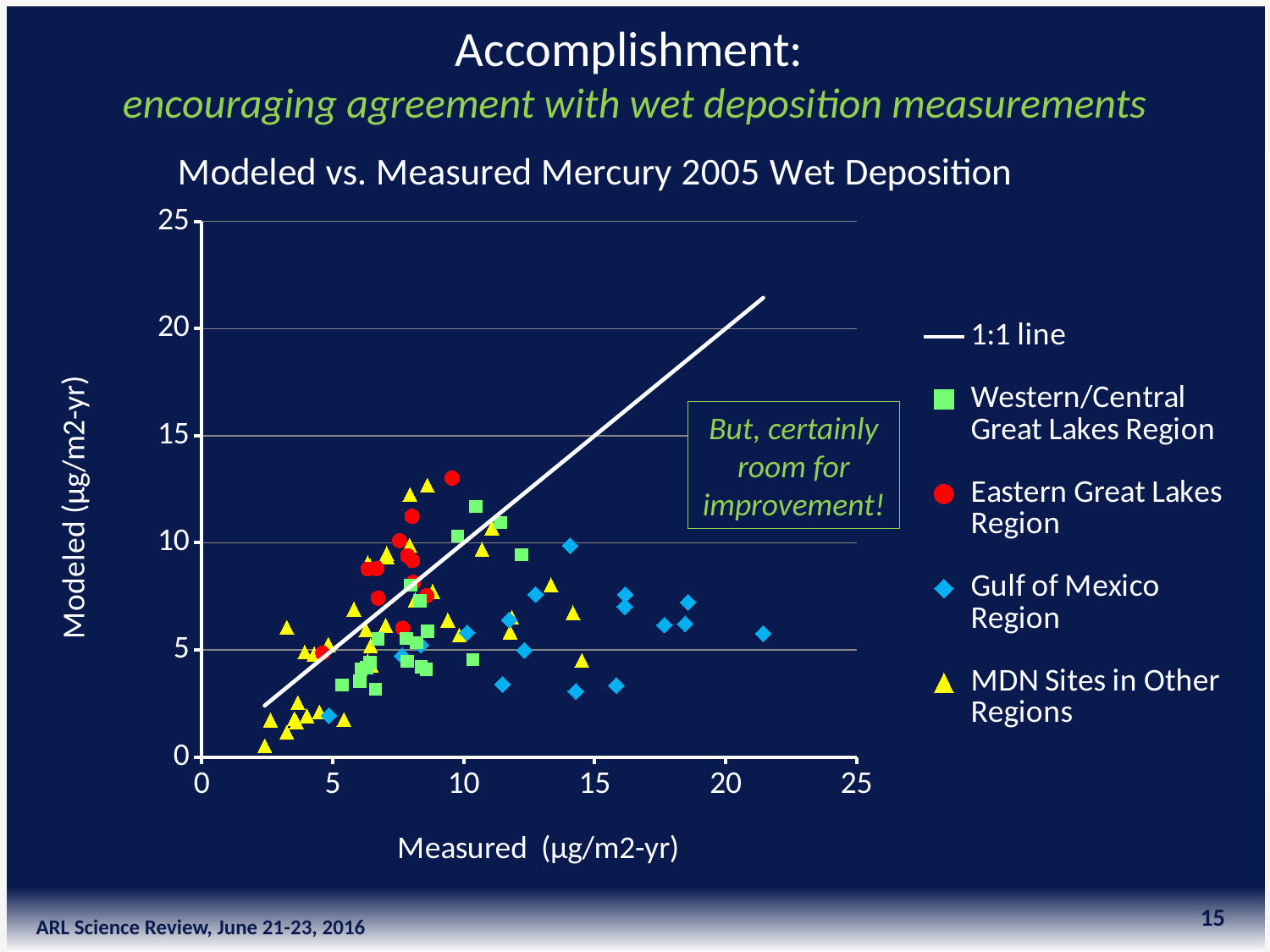
What kind of chart is shown on the slide? Scatter chart Is the highest modeled value among the Gulf of Mexico Region points greater or less than 15? less What is the title of the chart? Modeled vs. Measured Mercury 2005 Wet Deposition How many entries does the chart's legend list? 5 Is the largest measured value among the Gulf of Mexico Region points greater or less than 20? greater How many data series (excluding the 1:1 line) are plotted on the chart? 4 Which series contains the point with the largest measured value? Gulf of Mexico Region Is the largest measured value among the Eastern Great Lakes Region points greater or less than 15? less Which series contains the point with the lowest modeled value? MDN Sites in Other Regions What is the label of the vertical axis? Modeled (µg/m2-yr)